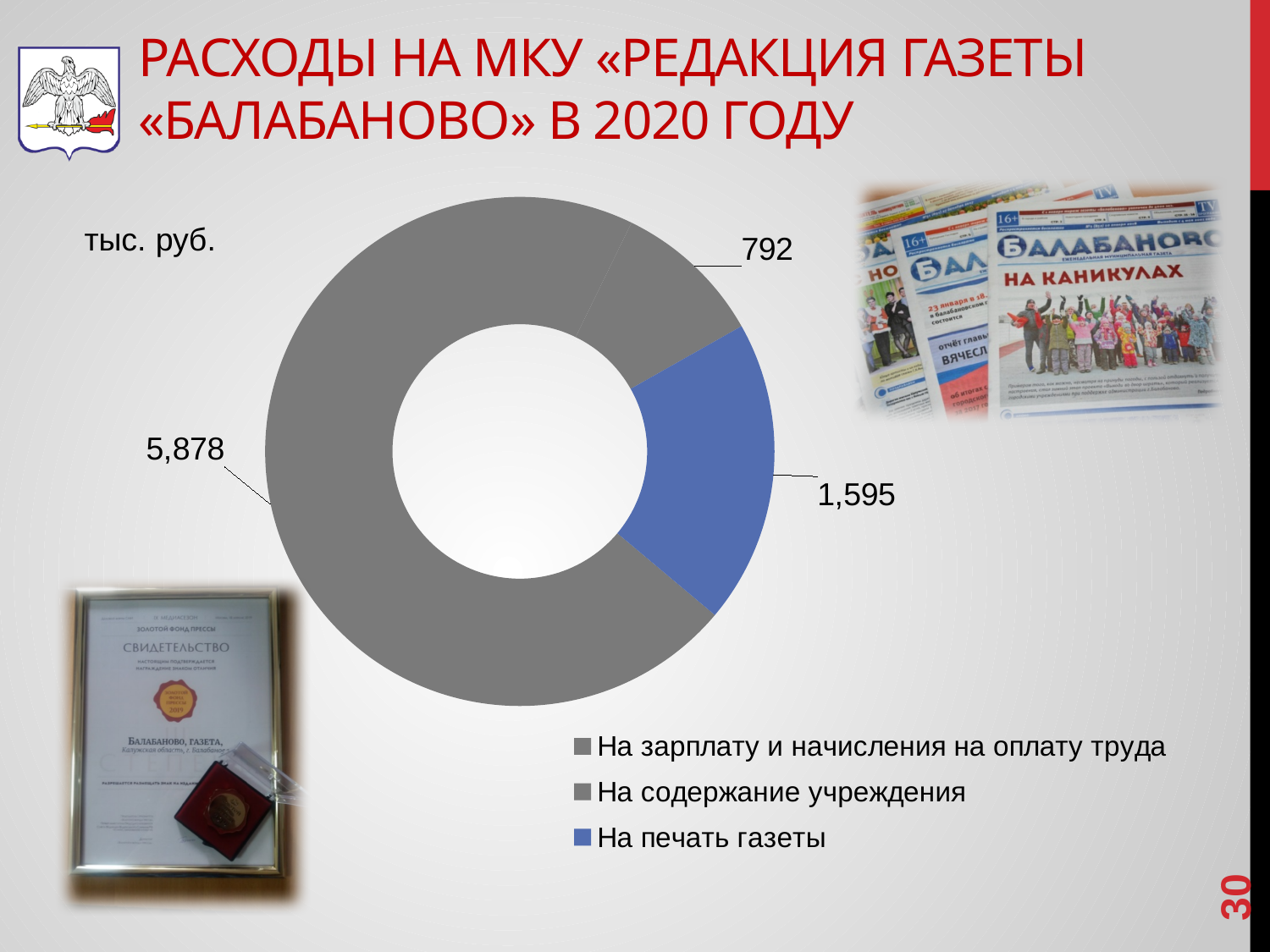
What is the value for «На содержание учреждения»? 792 What is the value for «На печать газеты»? 1,595 What is the total of all three values shown on the chart? 8,265 Which is larger: the value for «На печать газеты» or for «На содержание учреждения»? На печать газеты Which category has the largest value? На зарплату и начисления на оплату труда What is the value for «На зарплату и начисления на оплату труда»? 5,878 How many categories does the chart show? 3 What kind of chart is shown on the slide? Doughnut (pie) chart Which category has the smallest value? На содержание учреждения In what units are the chart values given, according to the label on the slide? тыс. руб. What is the difference between the values for «На зарплату и начисления на оплату труда» and «На печать газеты»? 4,283 What is the difference between the values for «На печать газеты» and «На содержание учреждения»? 803